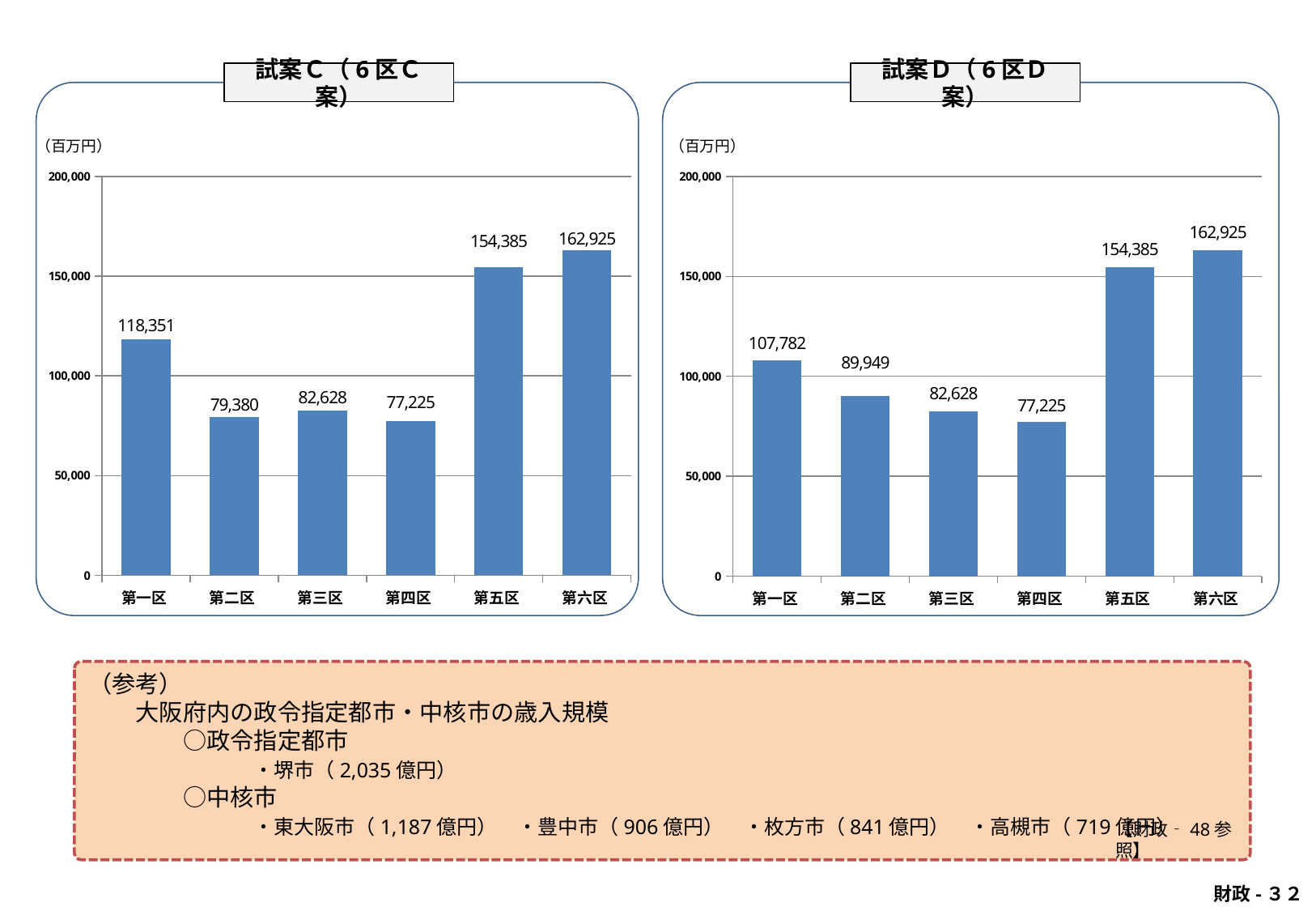
In the 試案C（6区C案） chart, what is the difference between the values for 第六区 and 第五区? 8,540 In the 試案D（6区D案） chart, what is the value for 第二区? 89,949 In the 試案D（6区D案） chart, is the value for 第一区 greater or less than 100,000? greater What kind of chart is the 試案D（6区D案） chart? bar chart In the 試案C（6区C案） chart, what is the value for 第一区? 118,351 In the 試案D（6区D案） chart, what is the value for 第五区? 154,385 In the 試案D（6区D案） chart, what is the difference between the values for 第一区 and 第二区? 17,833 In the 試案D（6区D案） chart, which district has the lowest value? 第四区 How many districts are shown on the x axis of the 試案C（6区C案） chart? 6 In the 試案C（6区C案） chart, which district has the highest value? 第六区 In the 試案C（6区C案） chart, which is larger: the value for 第二区 or the value for 第三区? 第三区 What unit is indicated above the y axis of the 試案C（6区C案） chart? 百万円